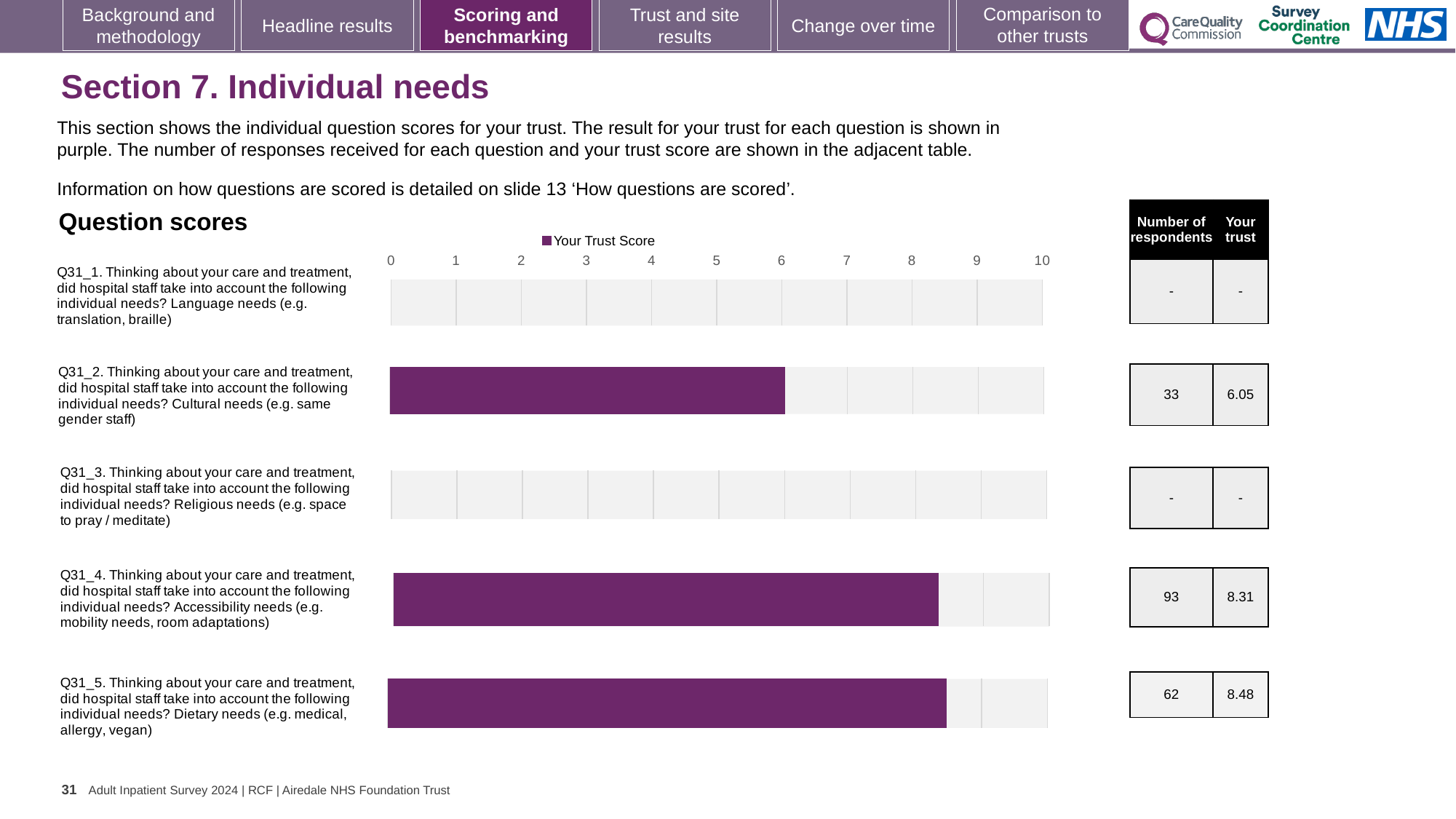
How many series does the legend list? 1 What is the trust score for Q31_2 (Cultural needs)? 6.05 What is the difference between the trust scores for Q31_5 and Q31_2? 2.43 What is the trust score for Q31_4 (Accessibility needs)? 8.31 Among the questions with a plotted score, which has the lowest trust score? Q31_2 (Cultural needs) Is the trust score for Q31_2 greater or less than 5? greater Which has the larger trust score, Q31_4 or Q31_2? Q31_4 What kind of chart is shown on the slide? Bar chart How many questions are listed in the chart? 5 Which question has the highest trust score? Q31_5 (Dietary needs) What is the trust score for Q31_5 (Dietary needs)? 8.48 How many respondents answered Q31_4 (Accessibility needs)? 93